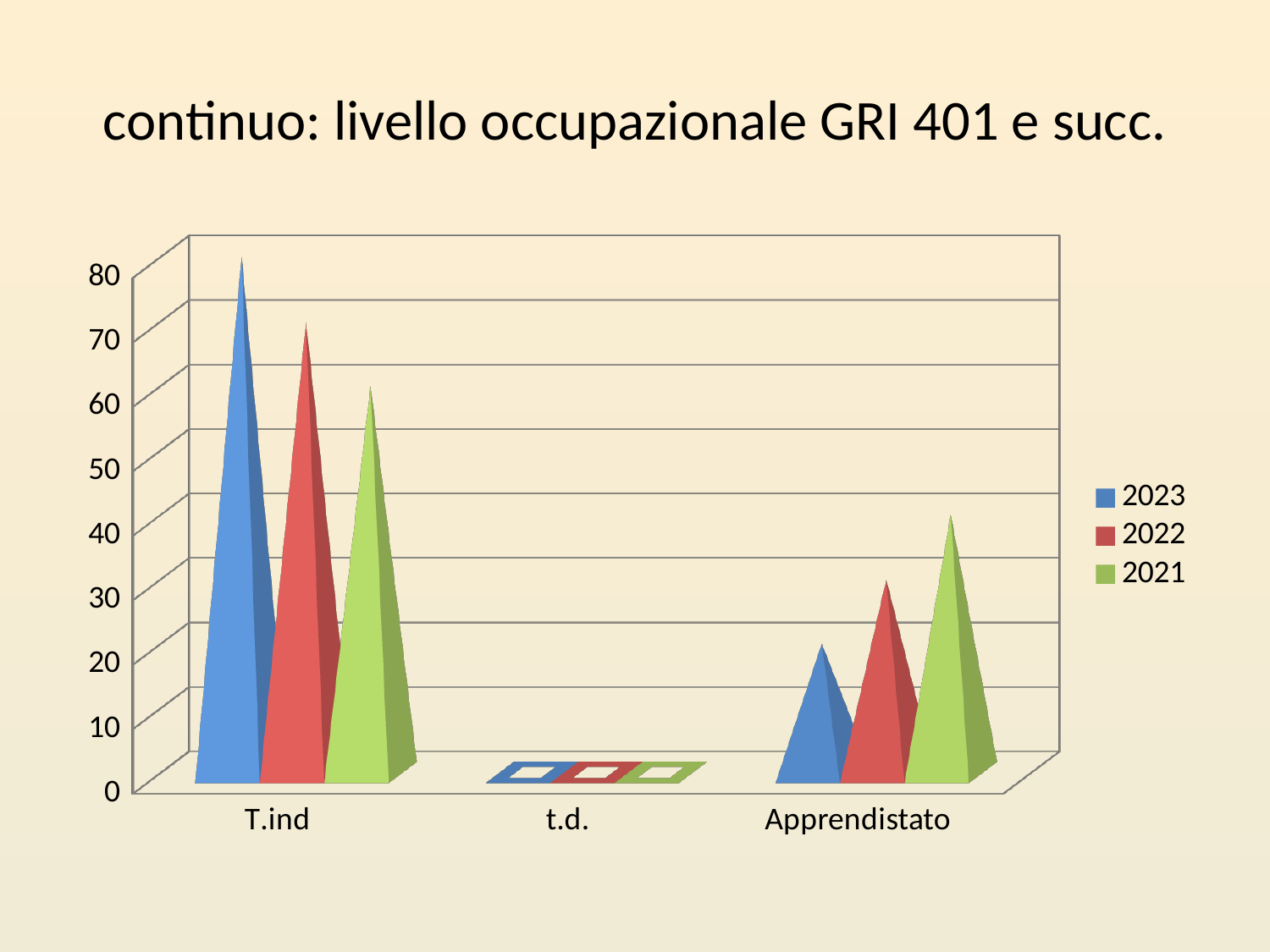
Which is larger, the 2023 value for T.ind or the 2023 value for Apprendistato? T.ind Which series has the highest value for Apprendistato? 2021 Is the value for T.ind in 2021 greater or less than 50? greater Is the value for Apprendistato in 2021 greater or less than 30? greater What are the entries listed in the chart legend? 2023, 2022, 2021 What kind of chart is shown on the slide? bar chart How many series does the legend list? 3 Which category has the lowest values across all series? t.d. Which series has the highest value for T.ind? 2023 Is the value for Apprendistato in 2023 greater or less than 30? less How many categories are shown on the x axis of the chart? 3